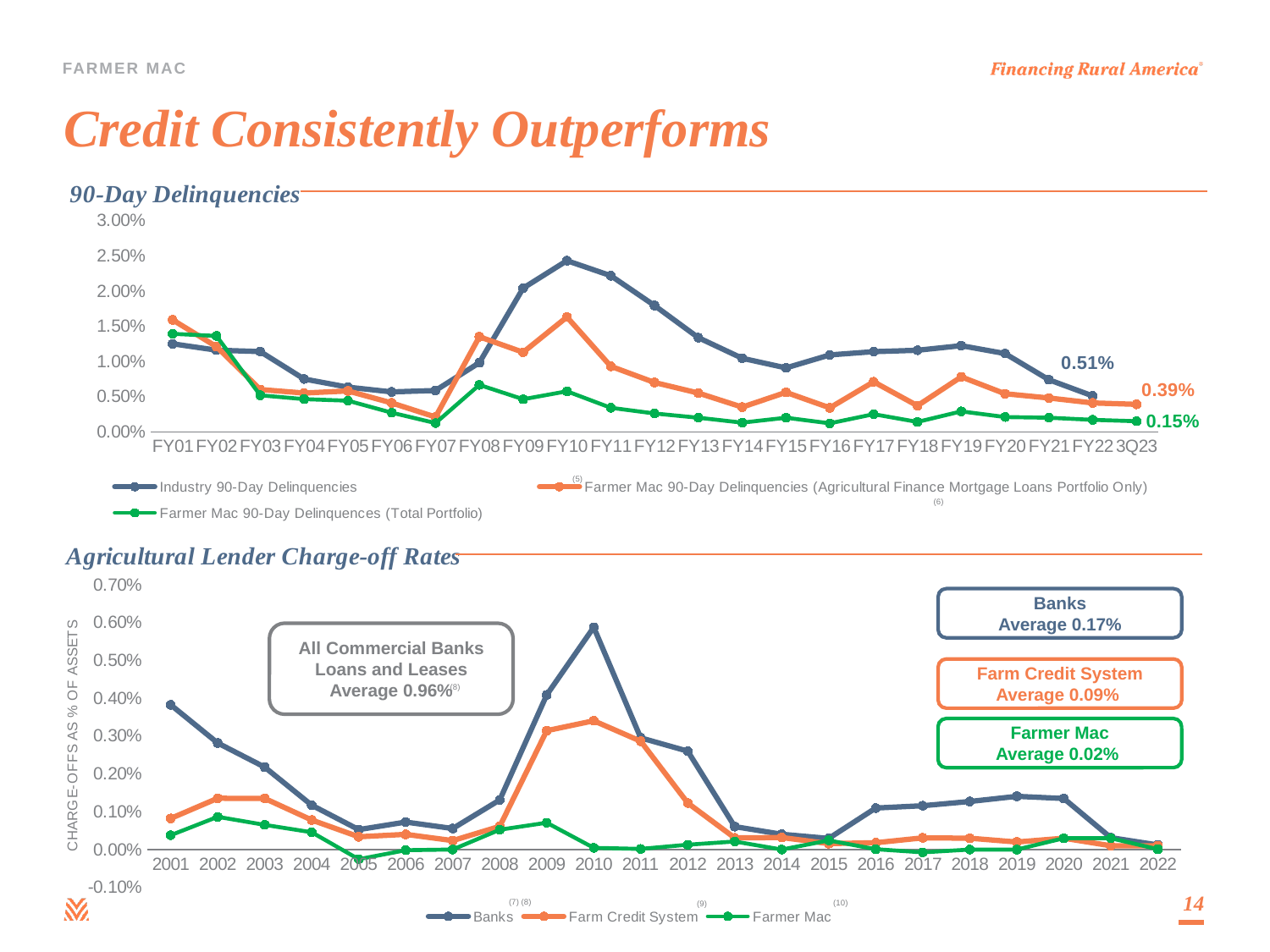
How many series does the legend of the 90-Day Delinquencies chart list? 3 In the Agricultural Lender Charge-off Rates chart, what is the average charge-off rate shown for Farm Credit System? 0.09% In the Agricultural Lender Charge-off Rates chart, is the Banks value for 2010 greater or less than 0.50%? greater In the Agricultural Lender Charge-off Rates chart, in which year does the Banks line reach its highest point? 2010 What kind of chart is the Agricultural Lender Charge-off Rates chart? line chart In the 90-Day Delinquencies chart, what is the value labelled for Farmer Mac 90-Day Delinquencies (Total Portfolio) at 3Q23? 0.15% In the 90-Day Delinquencies chart, is the Industry 90-Day Delinquencies value for FY10 greater or less than 2.00%? greater In the 90-Day Delinquencies chart, in which fiscal year does the Industry 90-Day Delinquencies line reach its highest point? FY10 In the Agricultural Lender Charge-off Rates chart, what is the difference between the Banks average and the Farmer Mac average? 0.15% In the 90-Day Delinquencies chart, what is the value labelled for Farmer Mac 90-Day Delinquencies (Agricultural Finance Mortgage Loans Portfolio Only) at 3Q23? 0.39%